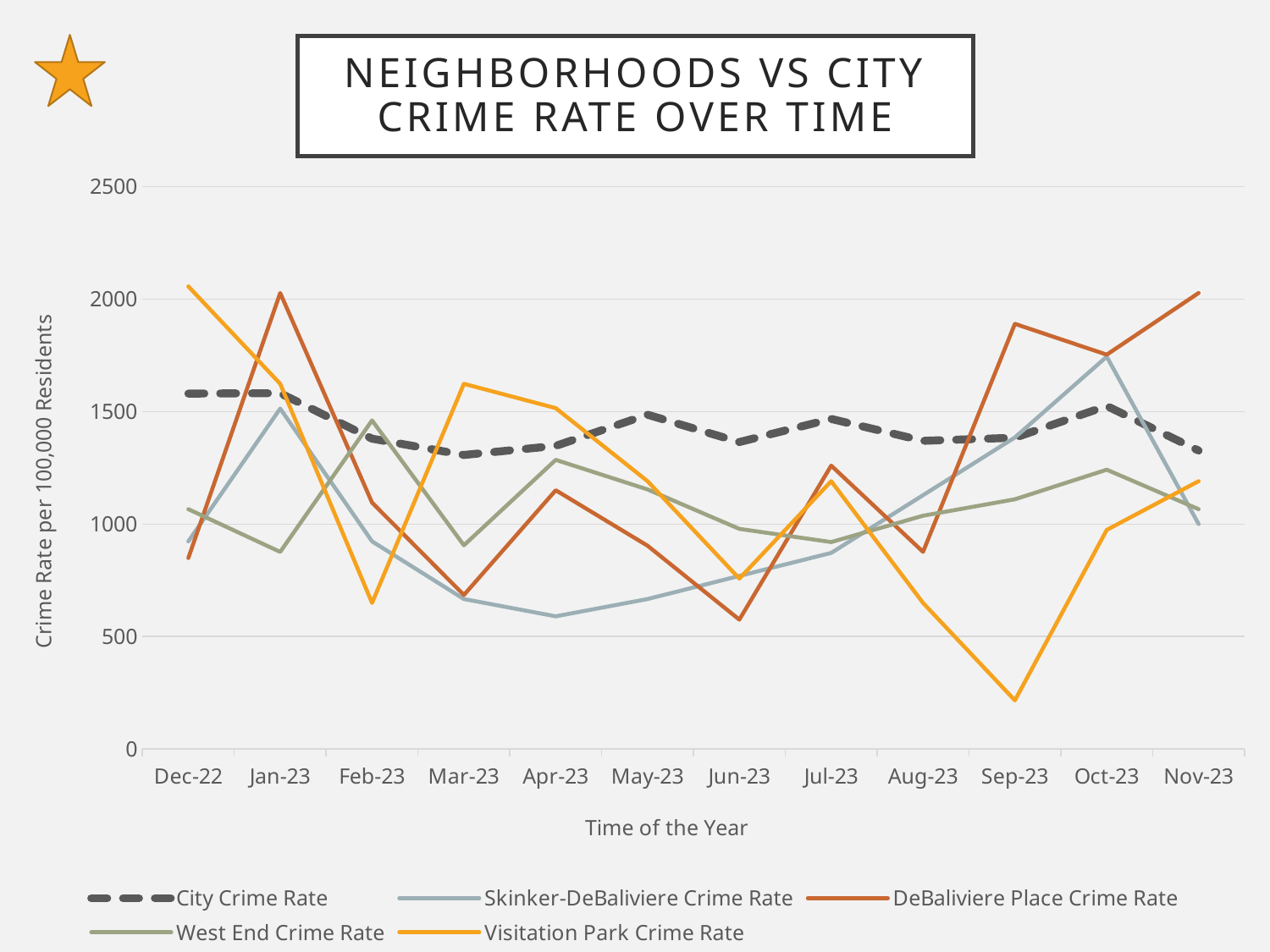
Is the Skinker-DeBaliviere Crime Rate in Apr-23 greater or less than 1000? less In Sep-23, which is larger: the DeBaliviere Place Crime Rate or the Visitation Park Crime Rate? DeBaliviere Place Crime Rate What kind of chart is shown on the slide? line chart Is the West End Crime Rate in Jan-23 greater or less than 1000? less How many time points are plotted along the x axis? 12 Does the City Crime Rate rise or fall from Dec-22 to Mar-23? fall Is the Visitation Park Crime Rate in Sep-23 greater or less than 500? less In which month is the Visitation Park Crime Rate lowest? Sep-23 How many series does the legend list? 5 In which month is the Visitation Park Crime Rate highest? Dec-22